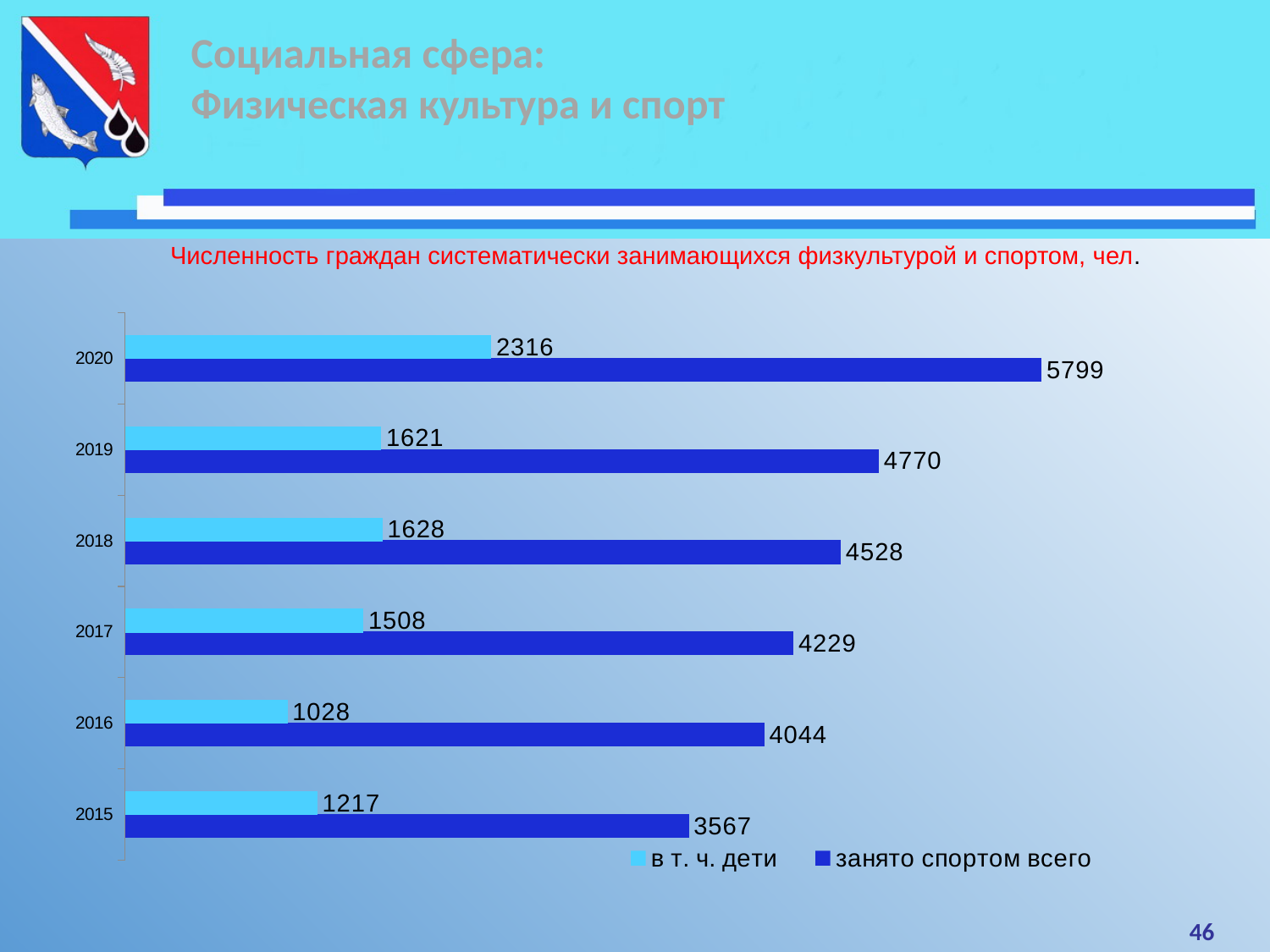
What is the value for "занято спортом всего" in 2020? 5799 What kind of chart is shown on the slide? Bar chart How many series does the legend list? 2 What is the title of the chart? Численность граждан систематически занимающихся физкультурой и спортом, чел. Which is larger: "в т. ч. дети" in 2018 or in 2019? 2018 Which year has the lowest value for "занято спортом всего"? 2015 What is the difference between "занято спортом всего" and "в т. ч. дети" in 2017? 2721 What is the difference between "занято спортом всего" in 2020 and in 2019? 1029 Which year has the highest value for "в т. ч. дети"? 2020 What is the value for "занято спортом всего" in 2015? 3567 How many years are shown on the chart? 6 What is the value for "в т. ч. дети" in 2016? 1028